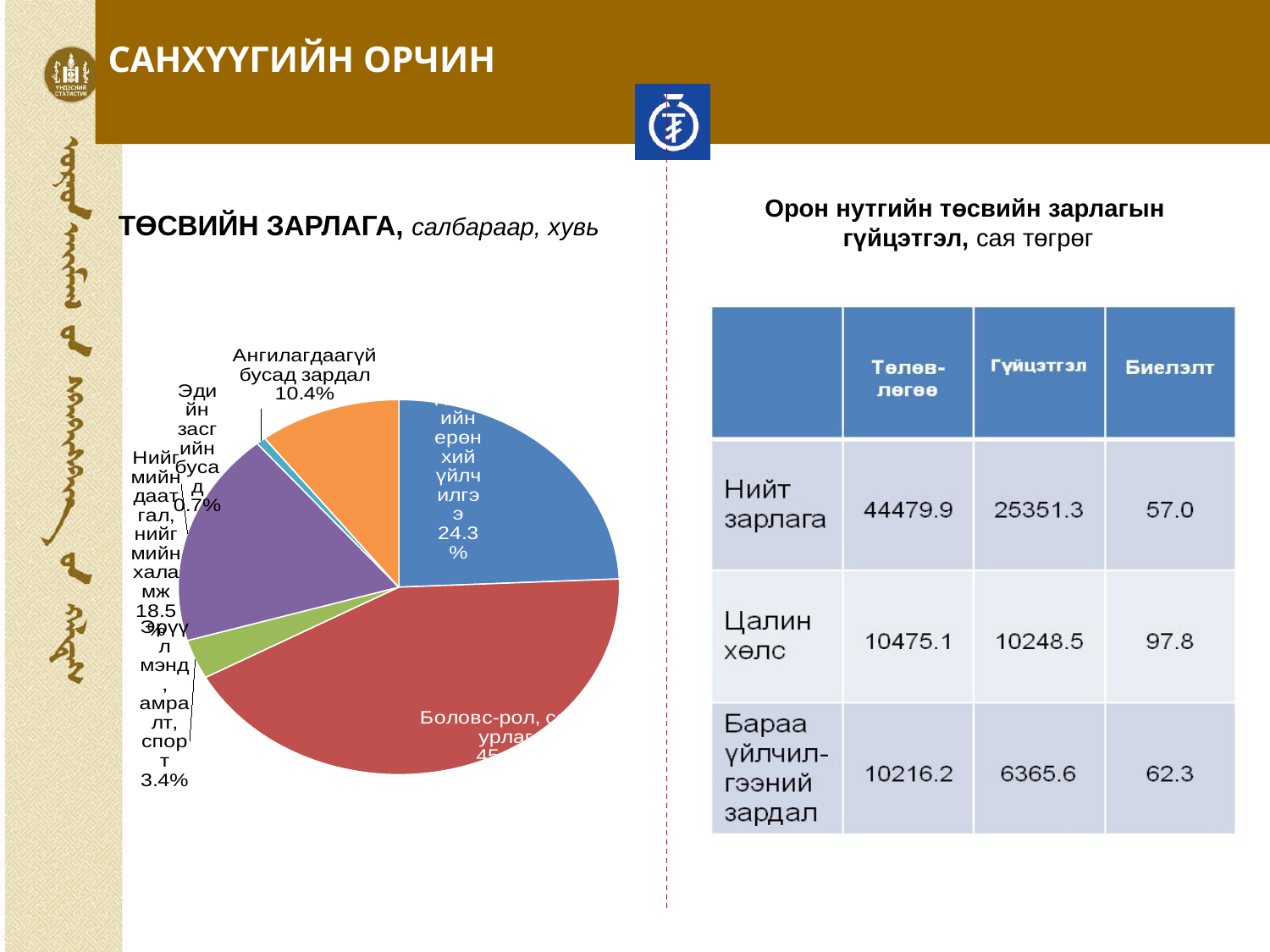
In the pie chart "ТӨСВИЙН ЗАРЛАГА", what colour is the largest slice? Red In the pie chart "ТӨСВИЙН ЗАРЛАГА", which slice has the smallest share? Эдийн засгийн бусад In the pie chart "ТӨСВИЙН ЗАРЛАГА", what is the difference in percentage points between the "ерөнхий үйлчилгээ" slice (24.3%) and "Нийгмийн даатгал, нийгмийн халамж" (18.5%)? 5.8 percentage points In the pie chart "ТӨСВИЙН ЗАРЛАГА", what share is labelled for "Ангилагдаагүй бусад зардал"? 10.4% In the pie chart "ТӨСВИЙН ЗАРЛАГА", what is the difference in percentage points between "Ангилагдаагүй бусад зардал" (10.4%) and "Эрүүл мэнд, амралт, спорт" (3.4%)? 7.0 percentage points In the pie chart "ТӨСВИЙН ЗАРЛАГА", what share is labelled for "Эрүүл мэнд, амралт, спорт"? 3.4% In the pie chart "ТӨСВИЙН ЗАРЛАГА", what share is labelled for "Эдийн засгийн бусад"? 0.7% In the pie chart "ТӨСВИЙН ЗАРЛАГА", how many slices does the pie have? 6 In the pie chart "ТӨСВИЙН ЗАРЛАГА", what share is labelled for the "ерөнхий үйлчилгээ" slice? 24.3% In the pie chart "ТӨСВИЙН ЗАРЛАГА", what share is labelled for "Нийгмийн даатгал, нийгмийн халамж"? 18.5% In the pie chart "ТӨСВИЙН ЗАРЛАГА", which is larger: "Нийгмийн даатгал, нийгмийн халамж" or "Ангилагдаагүй бусад зардал"? Нийгмийн даатгал, нийгмийн халамж What kind of chart is shown on the left of the slide under the title "ТӨСВИЙН ЗАРЛАГА, салбараар, хувь"? Pie chart